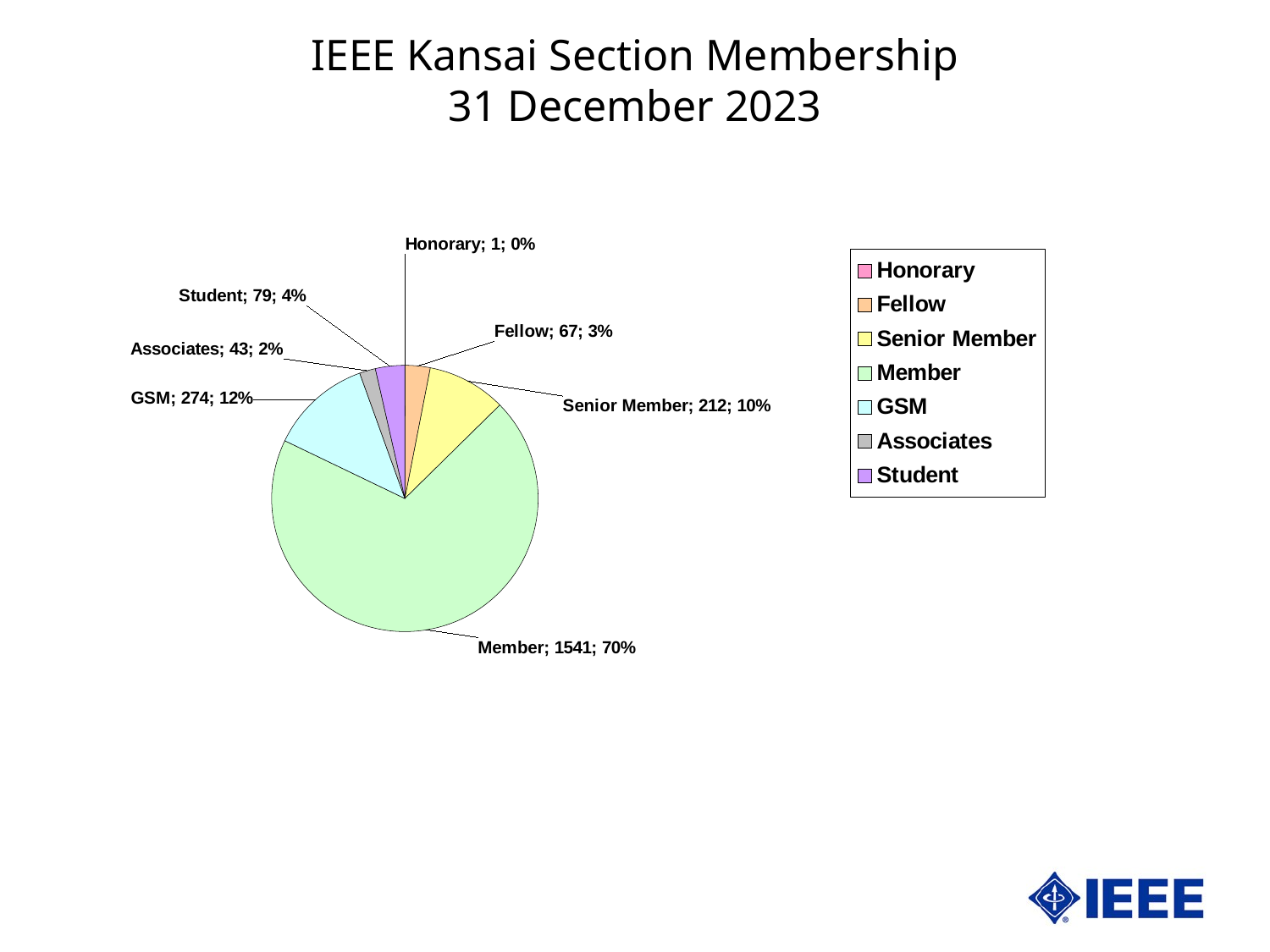
Which category has the smallest slice of the pie? Honorary What kind of chart is shown on the slide? pie chart What is the value for GSM? 274 What share of the pie does GSM represent? 12% How many categories does the legend list? 7 Which category has the largest slice of the pie? Member How many members are in the Member category? 1541 What is the difference between the Senior Member value and the Fellow value? 145 What is the value for Fellow? 67 What share of the pie does Student represent? 4% Which is larger, the value for Student or the value for Associates? Student What is the value for Senior Member? 212